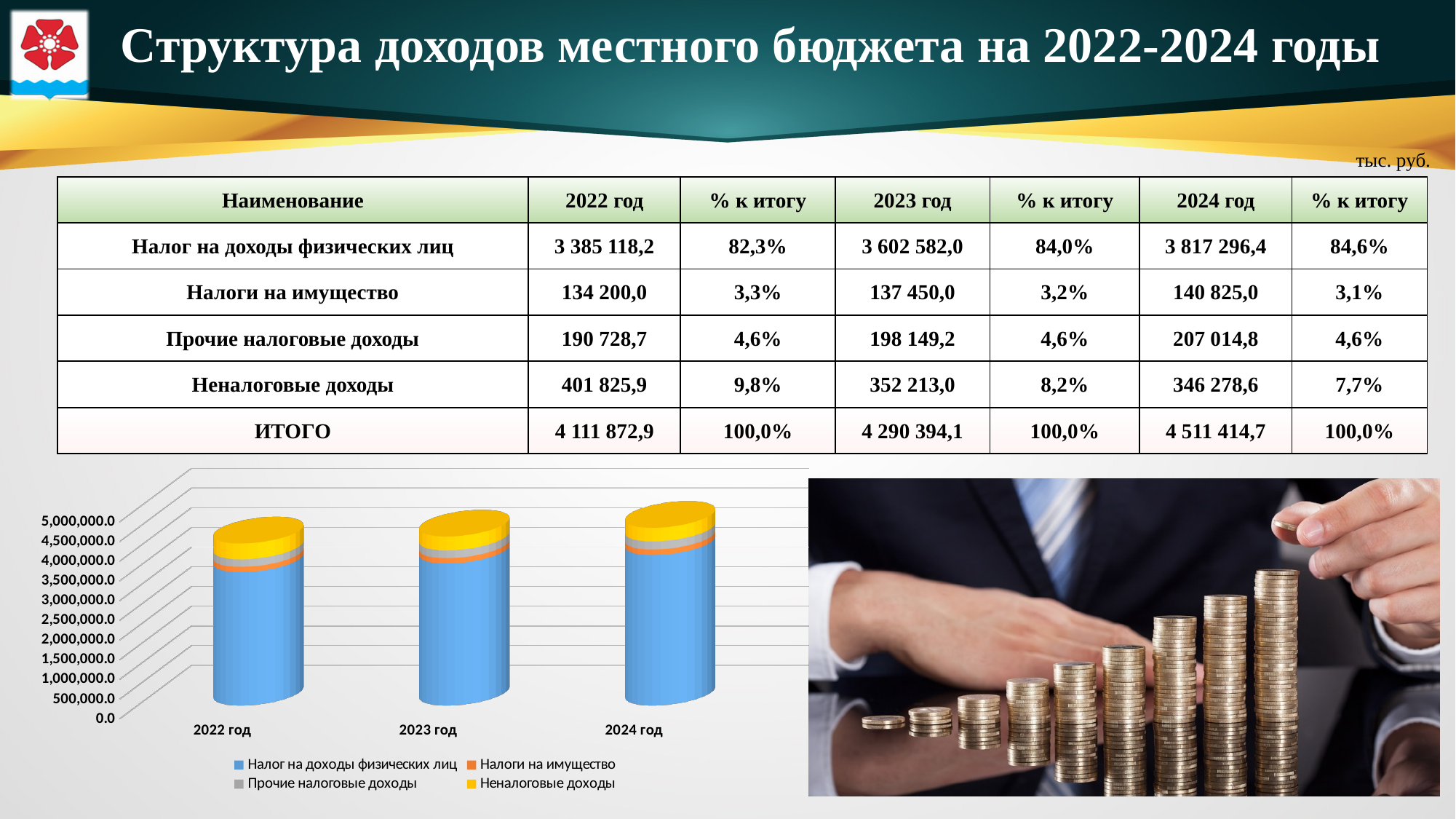
Which series is shown in blue in the chart? Налог на доходы физических лиц Which year has the highest stacked bar total in the chart? 2024 год Which series is shown in yellow in the chart? Неналоговые доходы What is the total of the stacked bar for 2023 год, as given in the table (ИТОГО)? 4 290 394,1 Is the total of the stacked bar for 2022 год greater or less than 4,000,000.0? greater What kind of chart is shown at the bottom left of the slide? bar chart What is the value of Налог на доходы физических лиц for 2024 год? 3 817 296,4 Do the total heights of the stacked bars rise or fall from 2022 год to 2024 год? rise How many categories (years) are shown on the x axis of the chart? 3 Is the total of the stacked bar for 2024 год greater or less than 5,000,000.0? less How many series does the chart legend list? 4 What is the value of Неналоговые доходы for 2022 год? 401 825,9